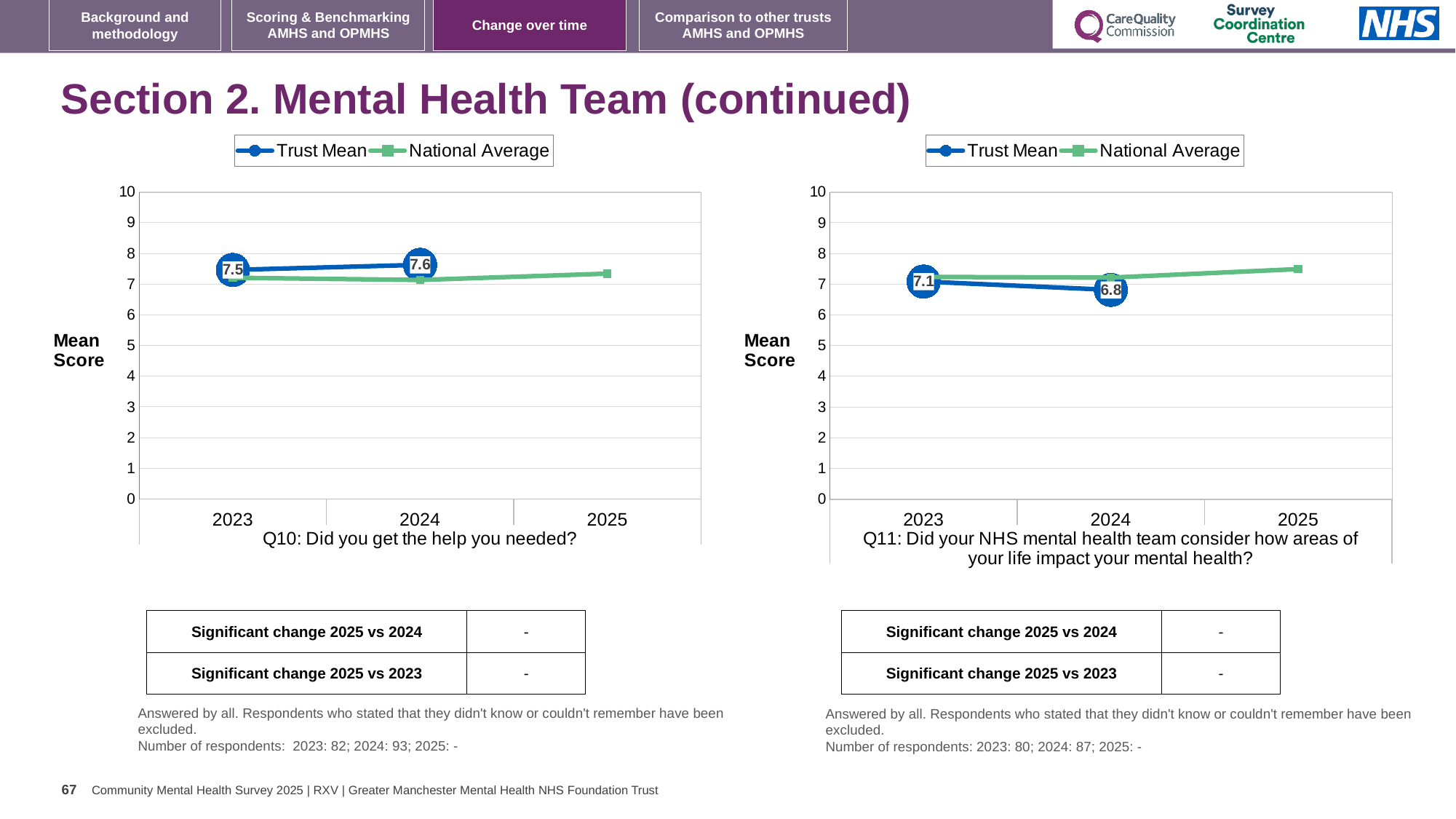
In the Q10 chart, what is the difference between the Trust Mean for 2024 and 2023? 0.1 How many years are shown on the x axis of the Q10 chart? 3 In the Q11 chart, what is the Trust Mean for 2024? 6.8 In the Q10 chart, what is the Trust Mean for 2023? 7.5 In the Q10 chart, what is the Trust Mean for 2024? 7.6 In the Q11 chart, which year has the higher Trust Mean, 2023 or 2024? 2023 In the Q11 chart, what is the difference between the Trust Mean for 2023 and 2024? 0.3 In the Q11 chart, does the Trust Mean rise or fall from 2023 to 2024? fall In the Q11 chart, what is the Trust Mean for 2023? 7.1 How many series does the legend of the Q11 chart list? 2 In the Q10 chart, is the National Average for 2025 greater or less than 5? greater What kind of chart is the Q10 chart? line chart